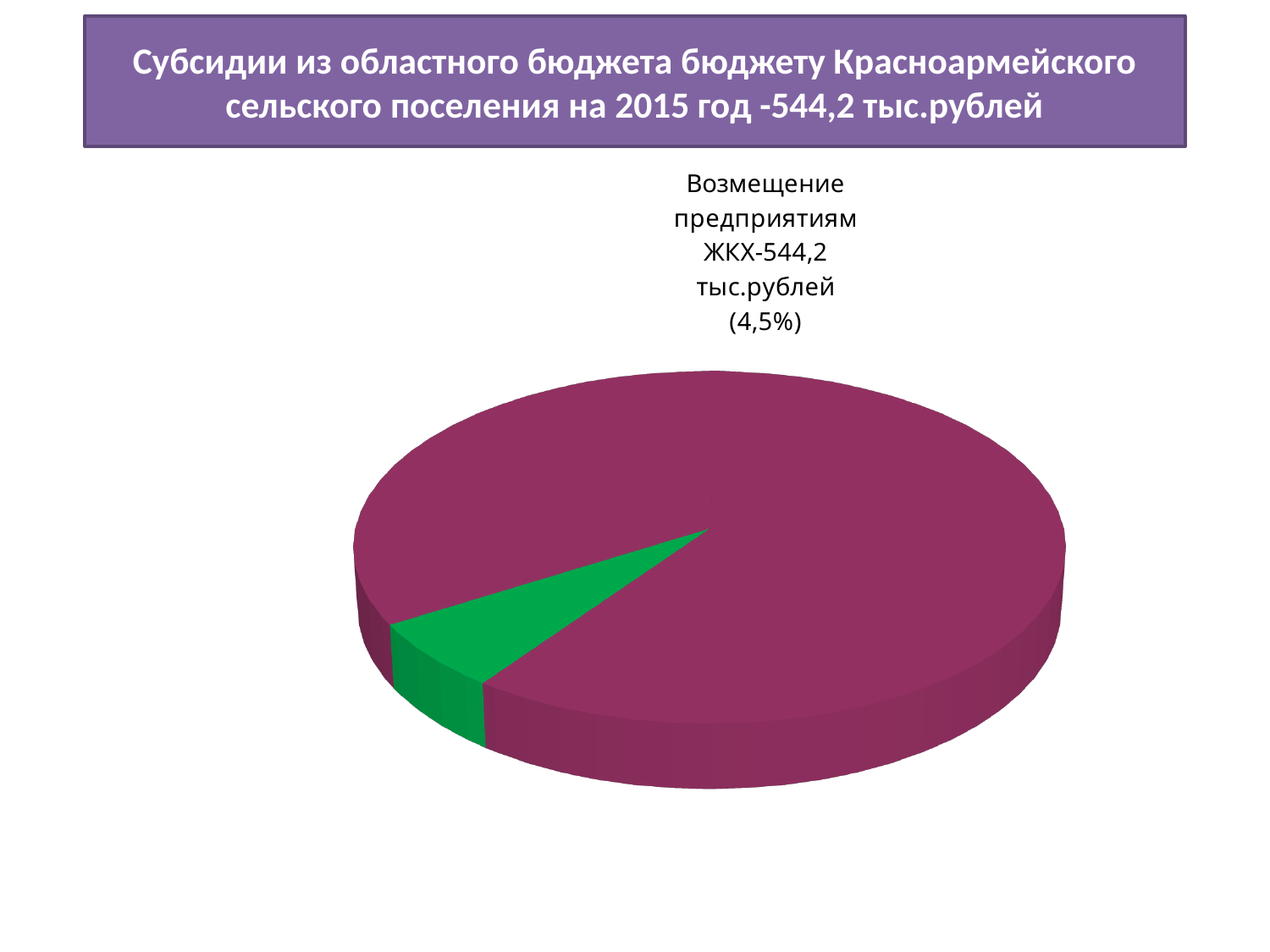
Which slice is larger, the green slice or the magenta slice? The magenta slice What kind of chart is shown on the slide? Pie chart Which slice of the pie is the smallest? Возмещение предприятиям ЖКХ What colour is the slice labelled "Возмещение предприятиям ЖКХ"? Green Is the share of the "Возмещение предприятиям ЖКХ" slice greater or less than 10%? less What share of the pie does the "Возмещение предприятиям ЖКХ" slice represent, as printed on the slide? 4,5% What total amount of subsidies for 2015 is stated in the slide title? 544,2 тыс.рублей What value is shown for the slice labelled "Возмещение предприятиям ЖКХ"? 544,2 тыс.рублей How many slices does the pie chart have? 2